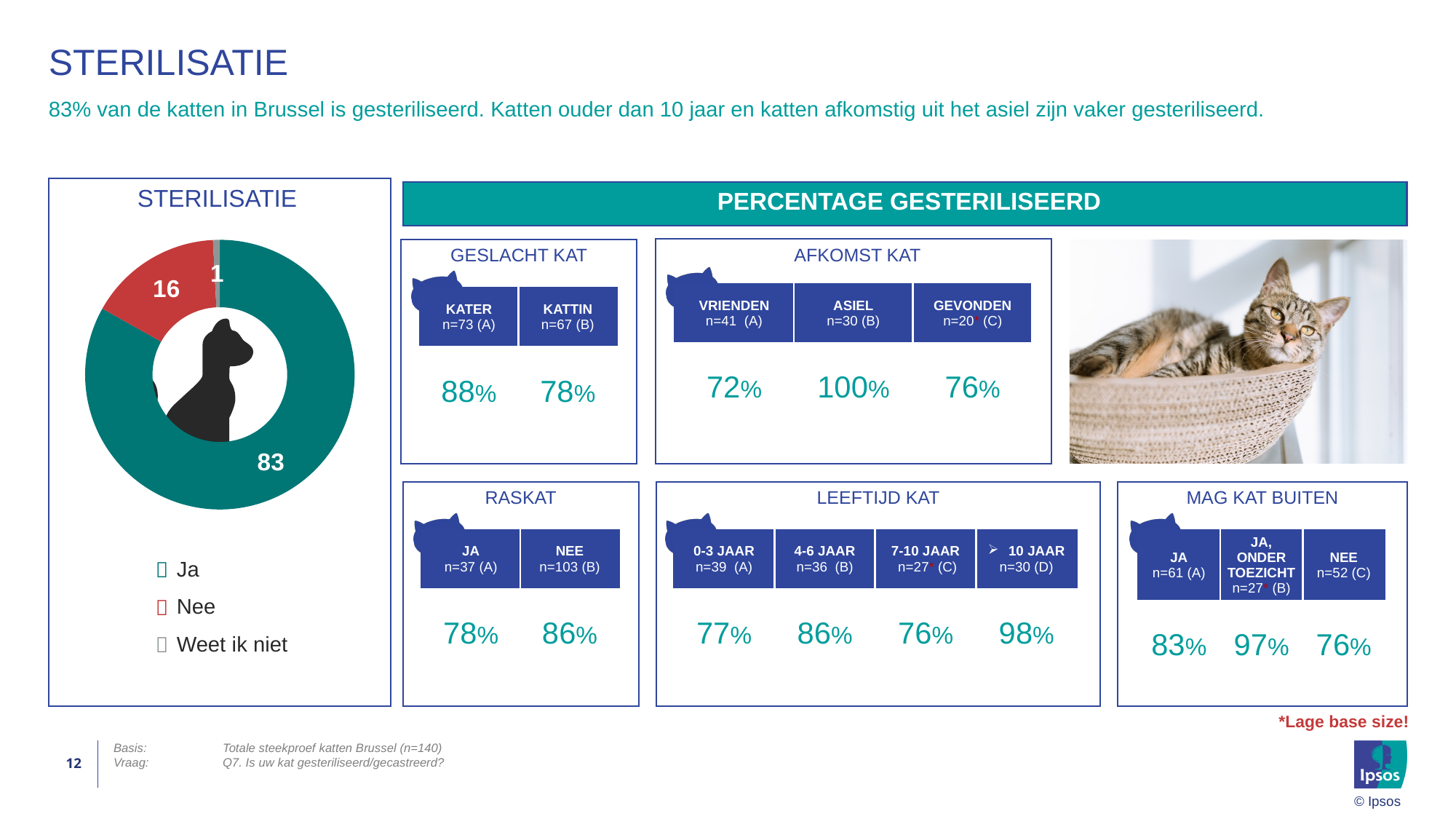
In the STERILISATIE chart, what value is shown for the 'Nee' slice? 16 In the STERILISATIE chart, what share of the whole does the 'Ja' slice represent? 83% In the STERILISATIE chart, which category has the smallest slice? Weet ik niet In the STERILISATIE chart, what value is shown for the 'Ja' slice? 83 In the STERILISATIE chart, what value is shown for the 'Weet ik niet' slice? 1 In the STERILISATIE chart, what is the difference between the 'Ja' and 'Nee' values? 67 In the STERILISATIE chart, which is larger: 'Nee' or 'Weet ik niet'? Nee How many entries does the legend of the STERILISATIE chart list? 3 In the STERILISATIE chart, which category has the largest slice? Ja In the STERILISATIE chart, what colour is the 'Nee' slice? Red What kind of chart is the STERILISATIE chart? Donut (pie) chart How many categories does the STERILISATIE chart show? 3